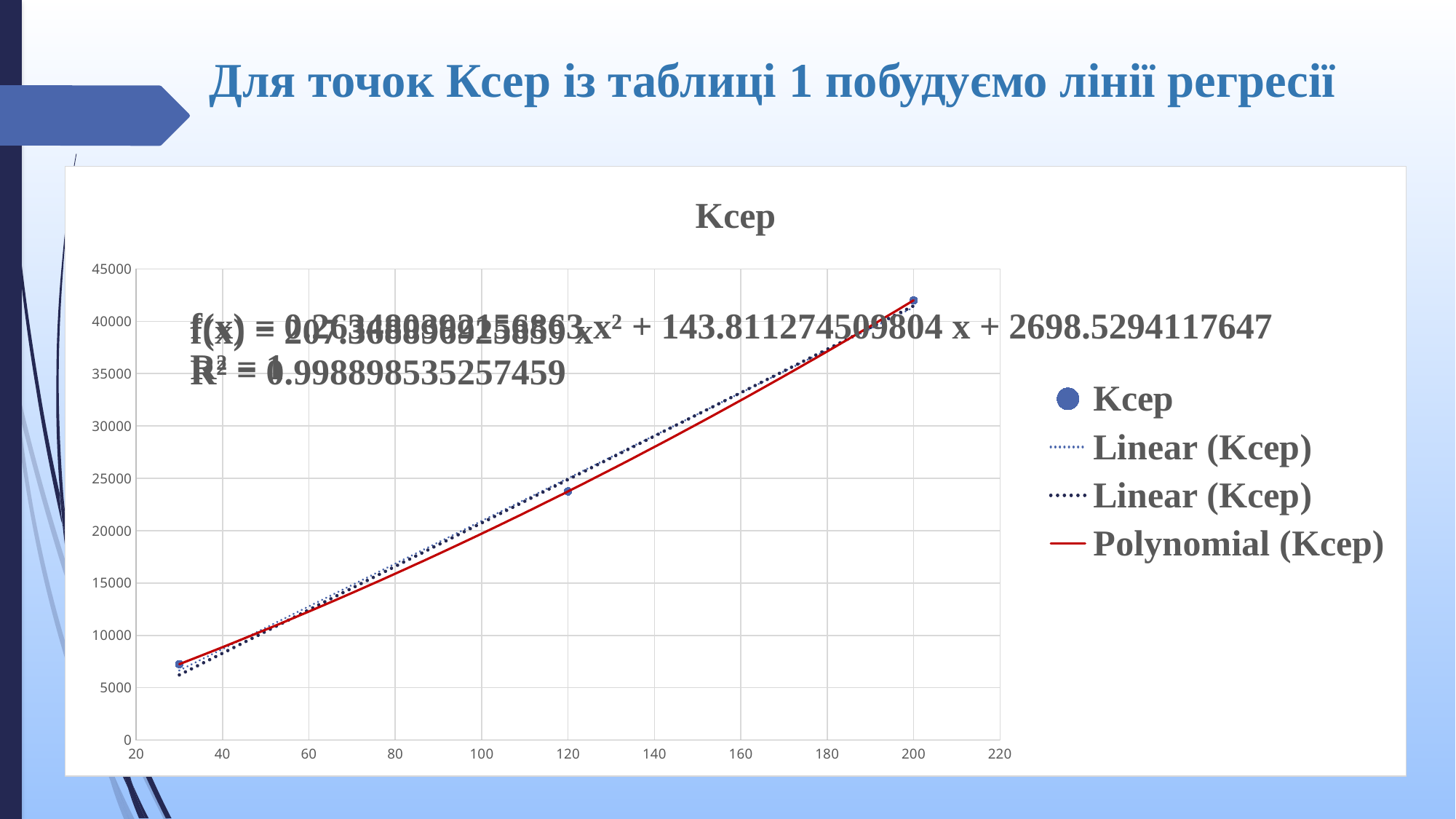
At which x value is the Ксер data point lowest? 30 Do the Ксер values rise or fall as x increases along the x axis? rise What is the title of the chart? Ксер Is the Ксер value at x = 120 greater or less than 25000? less How many data points are plotted for the Ксер series? 3 Is the Ксер value at x = 30 greater or less than 10000? less What kind of chart is shown on the slide? scatter chart How many entries does the chart legend list? 4 At which x value is the Ксер data point highest? 200 Is the Ксер value at x = 200 greater or less than 40000? greater What colour is the Polynomial (Ксер) trendline? red Which Ксер data point has the larger value, the one at x = 120 or the one at x = 30? x = 120